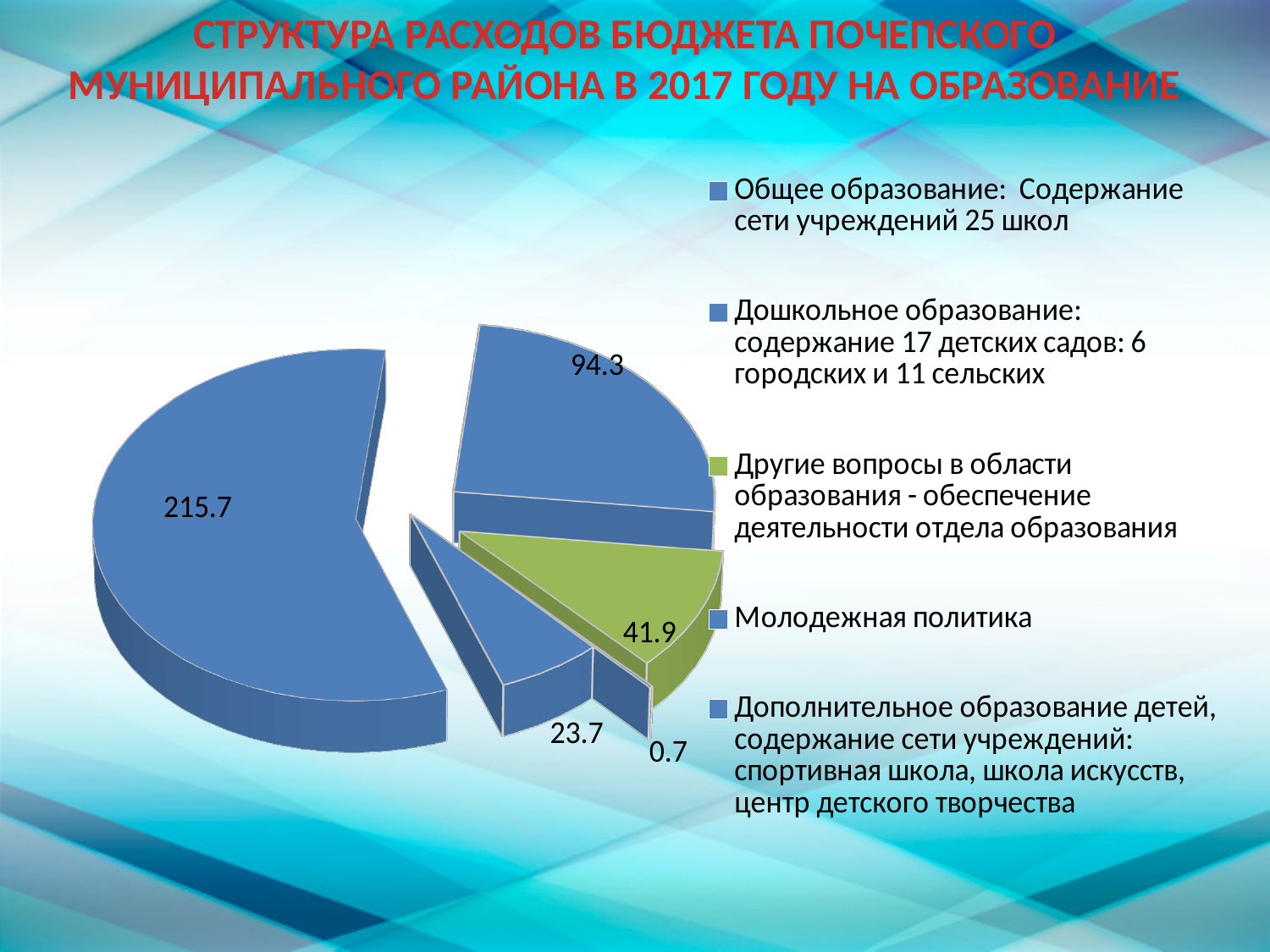
What is the value for Общее образование: Содержание сети учреждений 25 школ? 215.7 What is the value of the largest slice in the pie chart? 215.7 How many entries does the legend of the pie chart list? 5 What is the value of the smallest slice in the pie chart? 0.7 How many slices does the pie chart have? 5 What is the difference between the slice labelled 215.7 and the slice labelled 94.3? 121.4 What is the total of all slice values in the pie chart? 376.3 What is the value for Дошкольное образование? 94.3 What type of chart is shown on the slide? Pie chart Which legend entry is shown in green? Другие вопросы в области образования - обеспечение деятельности отдела образования Which is larger: the slice labelled 41.9 or the slice labelled 23.7? 41.9 What is the value of the green slice (Другие вопросы в области образования)? 41.9